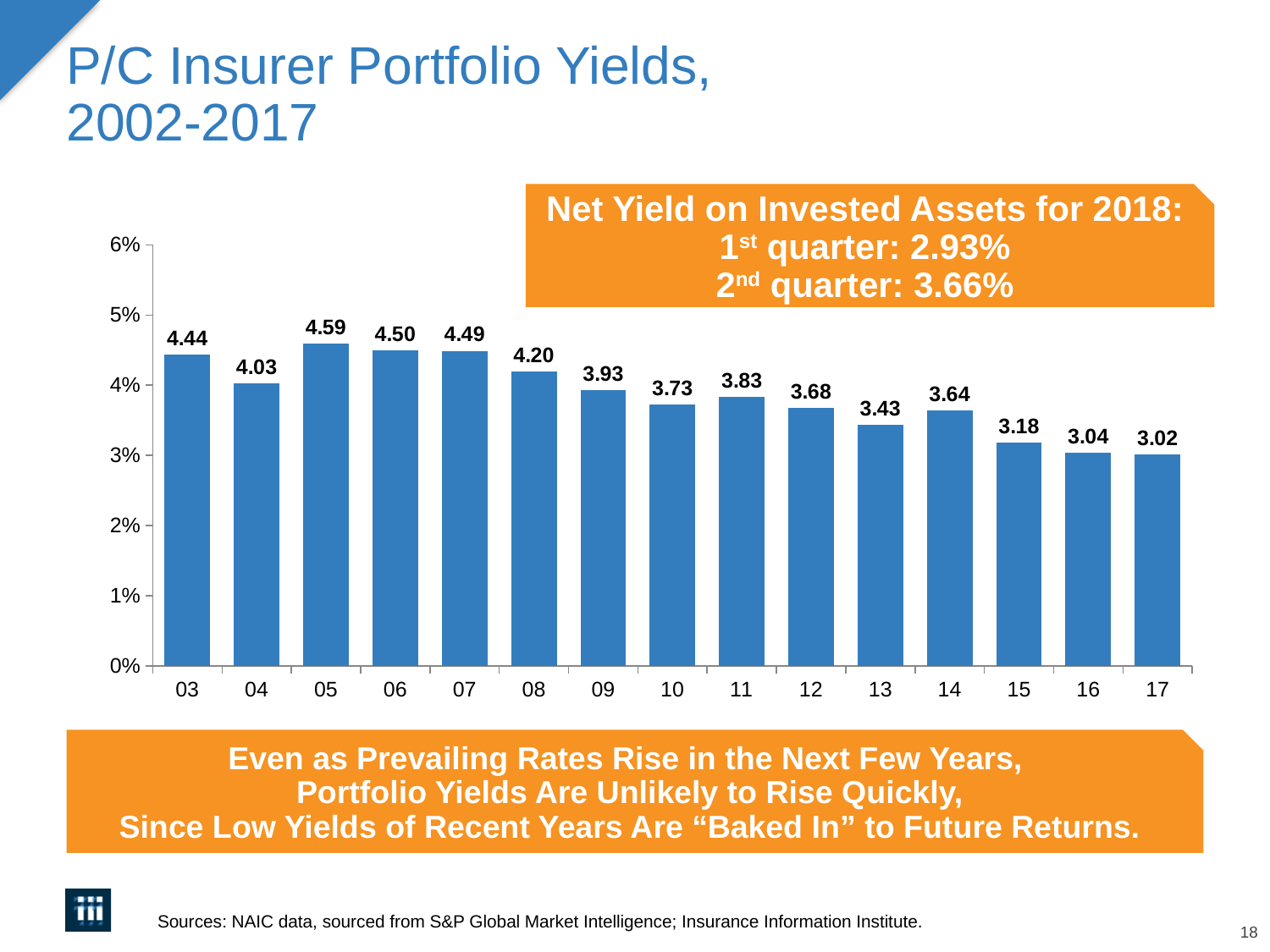
How many years are shown on the x axis? 15 What is the title of the chart on the slide? P/C Insurer Portfolio Yields, 2002-2017 Is the value for 2015 greater or less than 3%? greater What is the difference between the yields for 2003 and 2004? 0.41 Which year has the highest portfolio yield? 05 What is the portfolio yield shown for 2005? 4.59 Do the portfolio yields generally rise or fall from 2005 to 2017? fall What is the portfolio yield shown for 2017? 3.02 Which year has the lowest portfolio yield? 17 What is the portfolio yield shown for 2013? 3.43 Which year has a higher yield, 2011 or 2012? 11 What kind of chart is shown on the slide? bar chart